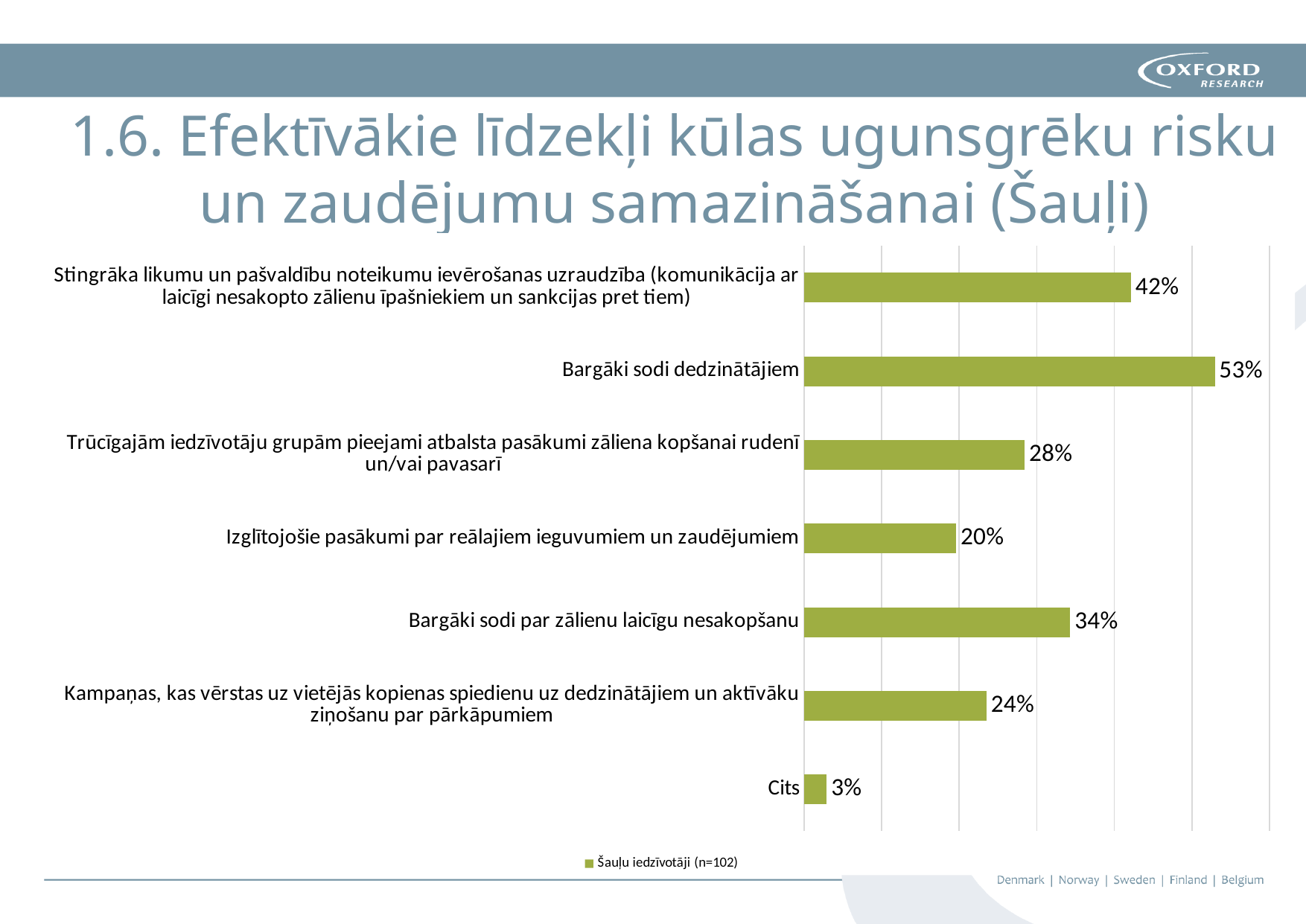
What is the value for "Bargāki sodi dedzinātājiem"? 53% How many categories are shown in the chart? 7 Which category has the lowest value? Cits What is the legend entry for the series shown in the chart? Šauļu iedzīvotāji (n=102) Which is larger: the value for "Trūcīgajām iedzīvotāju grupām pieejami atbalsta pasākumi zāliena kopšanai rudenī un/vai pavasarī" or the value for "Kampaņas, kas vērstas uz vietējās kopienas spiedienu uz dedzinātājiem un aktīvāku ziņošanu par pārkāpumiem"? Trūcīgajām iedzīvotāju grupām pieejami atbalsta pasākumi zāliena kopšanai rudenī un/vai pavasarī How many series does the legend list? 1 Which category has the highest value? Bargāki sodi dedzinātājiem What is the value for "Cits"? 3% What is the value for "Bargāki sodi par zālienu laicīgu nesakopšanu"? 34% What kind of chart is shown on the slide? Bar chart What is the difference between the values for "Bargāki sodi dedzinātājiem" and "Bargāki sodi par zālienu laicīgu nesakopšanu"? 19% What is the value for "Izglītojošie pasākumi par reālajiem ieguvumiem un zaudējumiem"? 20%